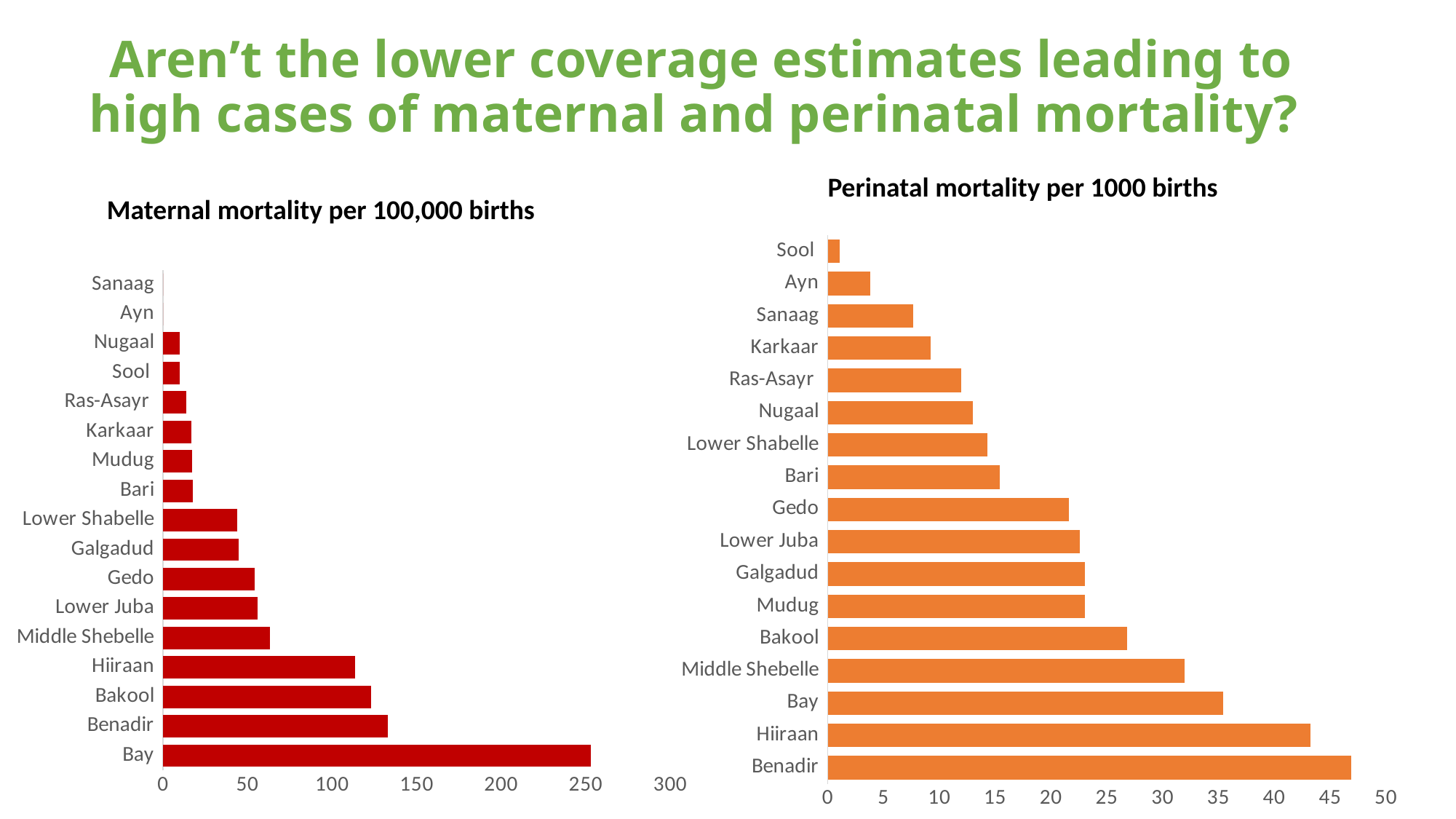
On the 'Perinatal mortality per 1000 births' chart, which is larger, the value for Hiiraan or the value for Bay? Hiiraan On the 'Maternal mortality per 100,000 births' chart, which is larger, the value for Middle Shebelle or the value for Gedo? Middle Shebelle What kind of chart is the 'Maternal mortality per 100,000 births' chart? Bar chart On the 'Perinatal mortality per 1000 births' chart, is the value for Hiiraan greater or less than 40? greater On the 'Perinatal mortality per 1000 births' chart, is the value for Gedo greater or less than 20? greater On the 'Perinatal mortality per 1000 births' chart, which region has the lowest value? Sool How many regions are shown on the 'Perinatal mortality per 1000 births' chart? 17 On the 'Maternal mortality per 100,000 births' chart, which region has the highest value? Bay On the 'Perinatal mortality per 1000 births' chart, which region has the highest value? Benadir On the 'Maternal mortality per 100,000 births' chart, is the value for Benadir greater or less than 100? greater